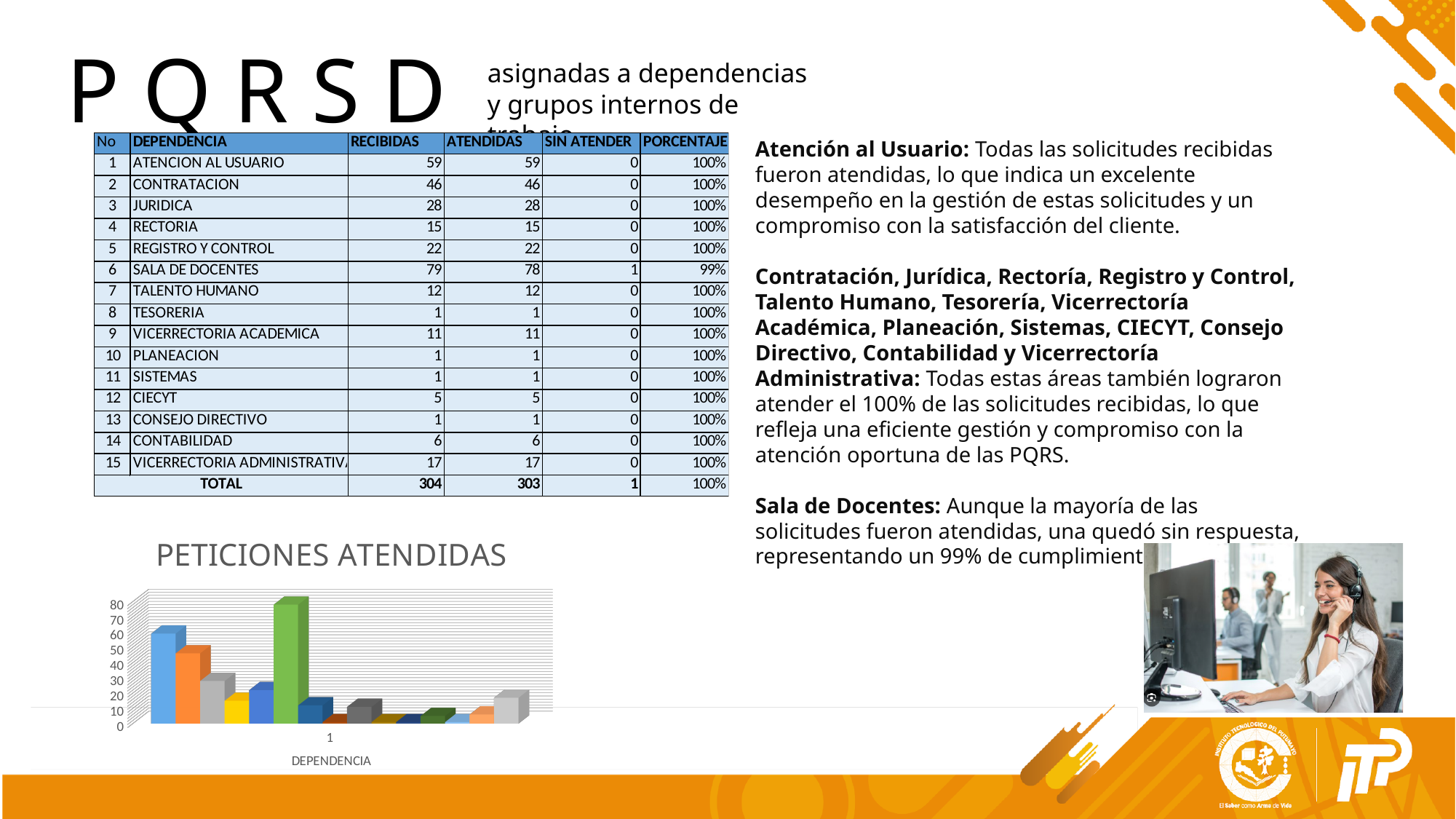
In the PETICIONES ATENDIDAS chart, is the value of the grey bar next to the orange bar greater or less than 40? less In the PETICIONES ATENDIDAS chart, is the value of the first (blue) bar greater or less than 50? greater What label is shown on the horizontal axis of the PETICIONES ATENDIDAS chart? DEPENDENCIA What is the title of the chart at the bottom left of the slide? PETICIONES ATENDIDAS What kind of chart is shown under the title PETICIONES ATENDIDAS? bar chart In the PETICIONES ATENDIDAS chart, is the value of the orange bar greater or less than 30? greater How many bars are plotted in the PETICIONES ATENDIDAS chart? 15 What is the highest tick value shown on the vertical axis of the PETICIONES ATENDIDAS chart? 80 In the PETICIONES ATENDIDAS chart, what colour is the tallest bar? green In the PETICIONES ATENDIDAS chart, which is taller, the green bar or the first blue bar? the green bar